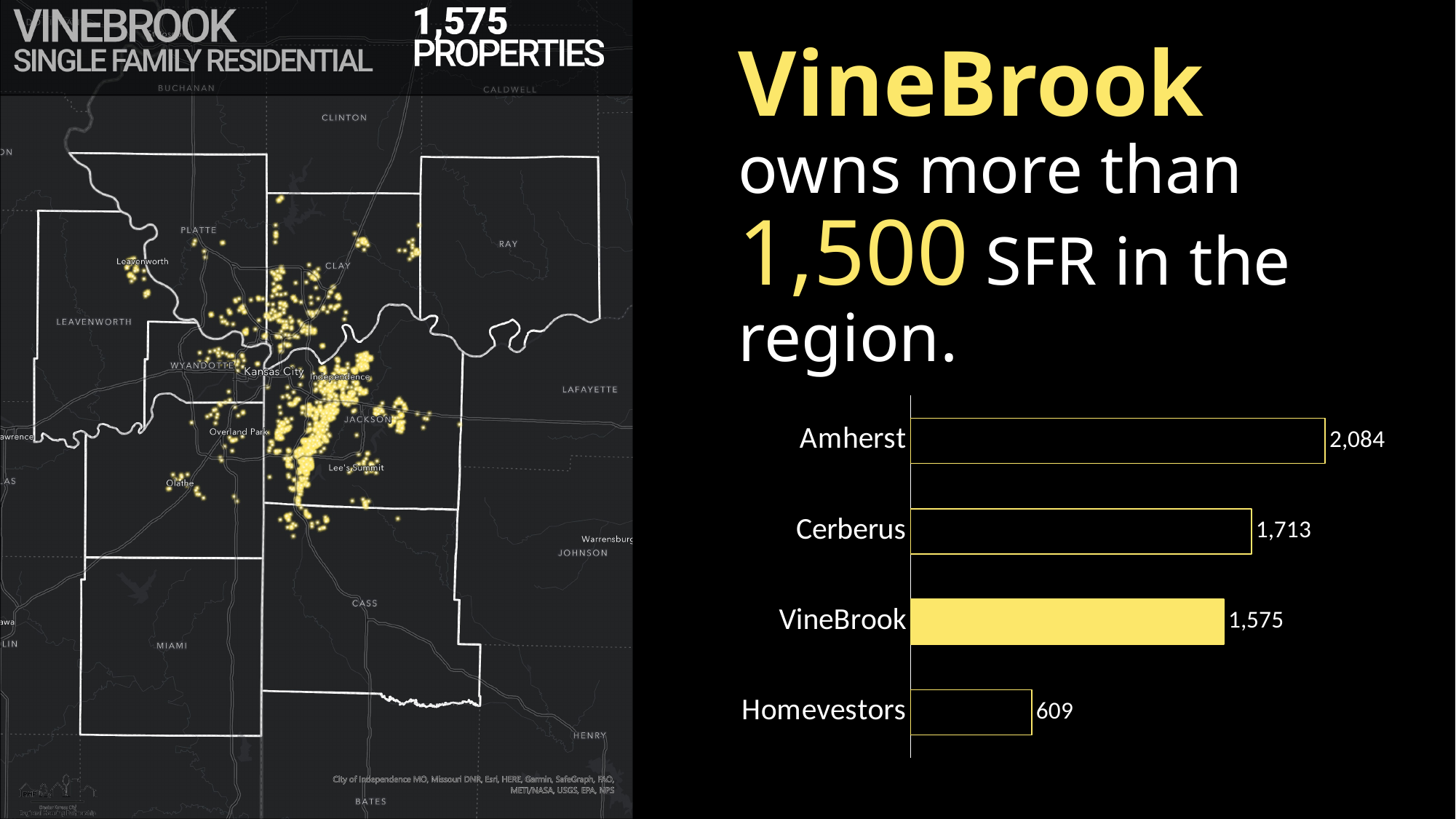
What value is shown for VineBrook in the bar chart? 1,575 Which bar in the chart is filled in solid yellow? VineBrook What value is shown for Amherst in the bar chart? 2,084 Which category has the highest value in the bar chart? Amherst What kind of chart is shown on the slide? Bar chart What is the difference between the values for Cerberus and Homevestors? 1,104 Which has a larger value, Cerberus or VineBrook? Cerberus What is the difference between the values for Amherst and VineBrook? 509 What value is shown for Homevestors in the bar chart? 609 What value is shown for Cerberus in the bar chart? 1,713 How many categories are shown in the bar chart? 4 Which category has the lowest value in the bar chart? Homevestors